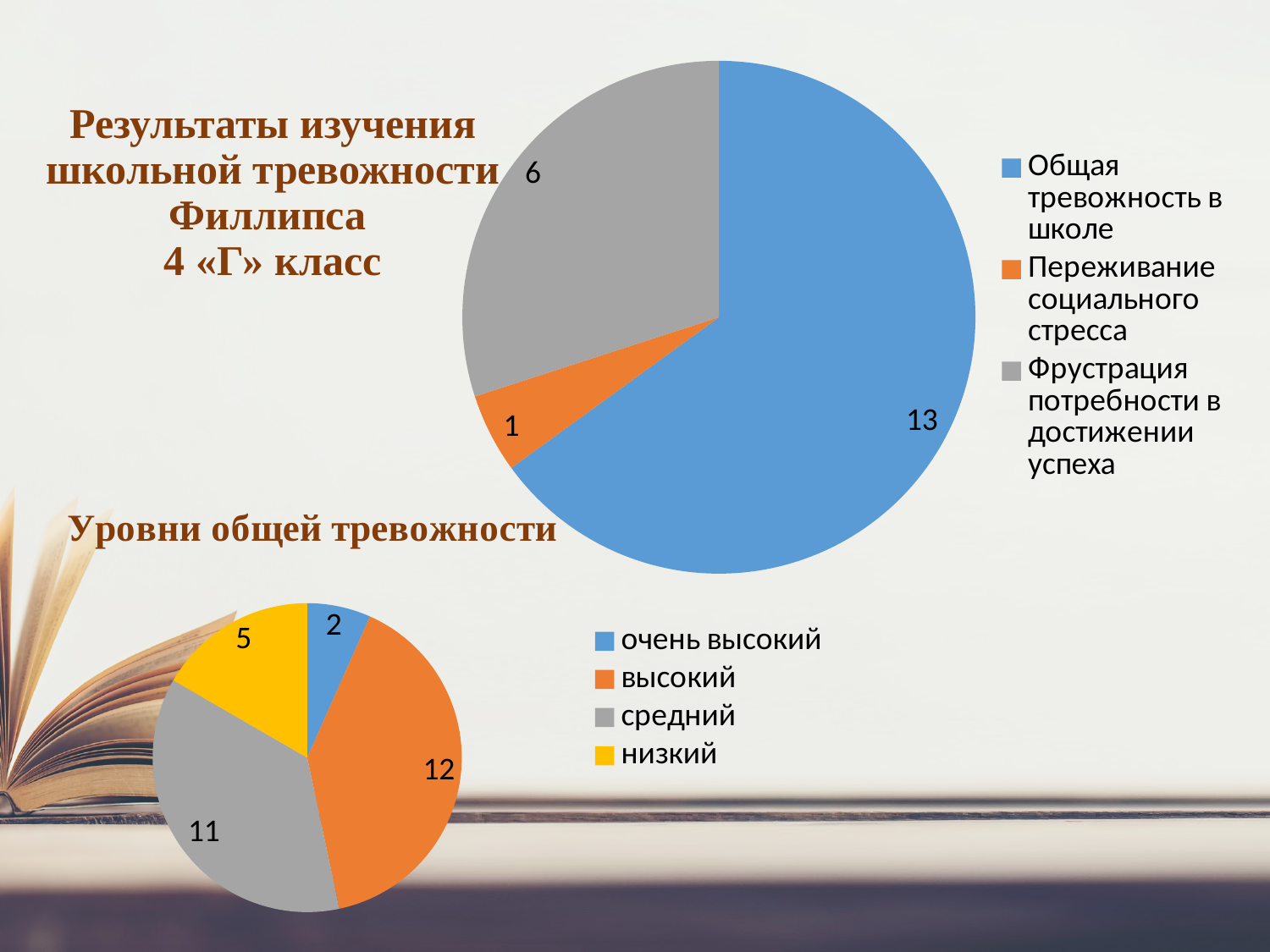
In the top pie chart, which category has the largest slice? Общая тревожность в школе In the top pie chart, what is the value for «Фрустрация потребности в достижении успеха»? 6 In the bottom pie chart «Уровни общей тревожности», what is the value for «высокий»? 12 In the bottom pie chart «Уровни общей тревожности», what share of the whole does «высокий» represent? 40% In the top pie chart, what share of the whole does «Общая тревожность в школе» represent? 65% In the top pie chart, what is the difference between «Общая тревожность в школе» and «Фрустрация потребности в достижении успеха»? 7 In the top pie chart, what is the value for «Общая тревожность в школе»? 13 In the bottom pie chart «Уровни общей тревожности», how many categories does the legend list? 4 In the bottom pie chart «Уровни общей тревожности», which level has the smallest slice? очень высокий In the bottom pie chart «Уровни общей тревожности», what is the value for «низкий»? 5 In the top pie chart, what is the value for «Переживание социального стресса»? 1 What type of chart is the bottom chart «Уровни общей тревожности»? Pie chart